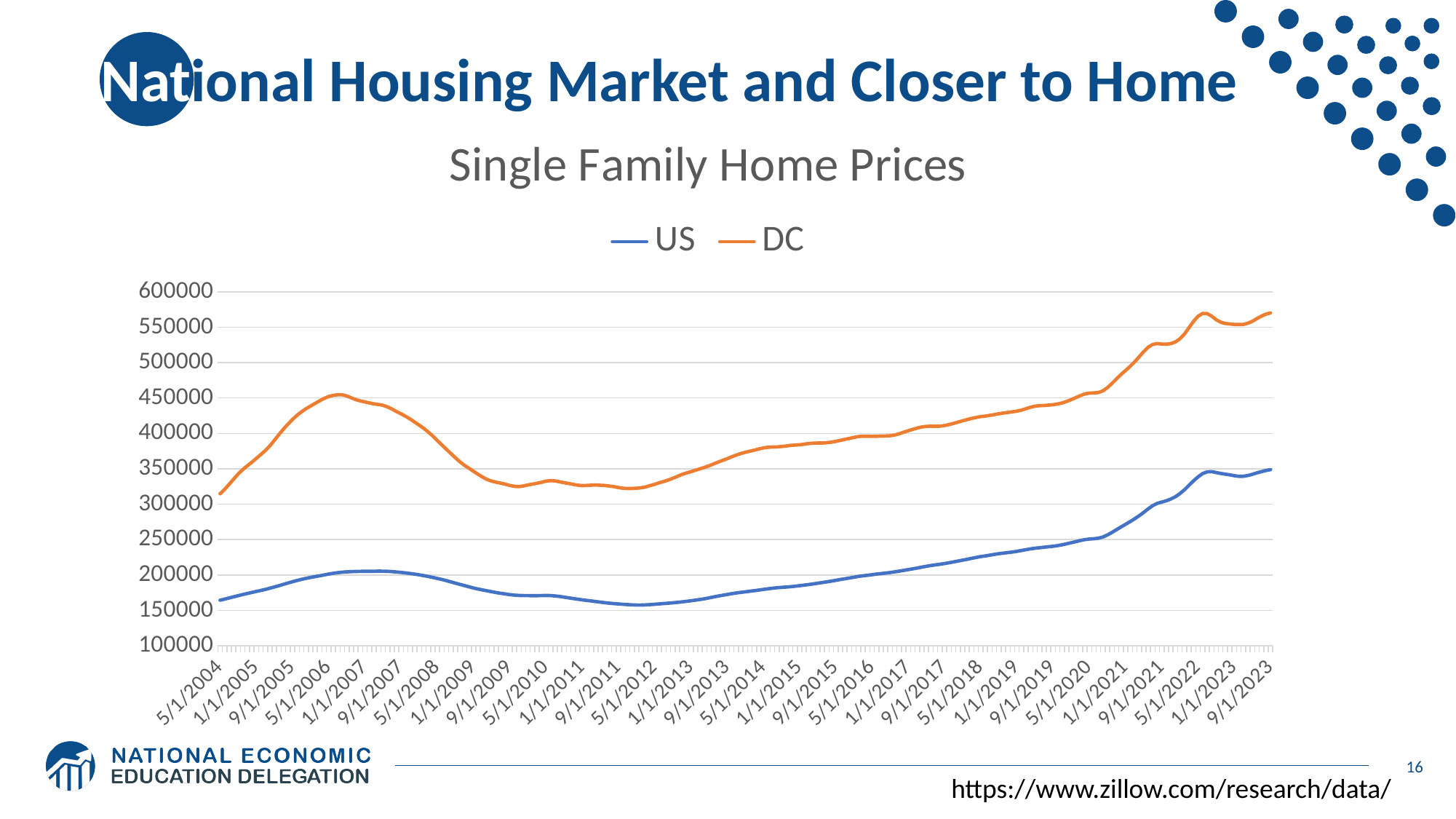
What is the title of the chart? Single Family Home Prices Is the value for US at 5/1/2004 greater or less than 150000? greater Is the value for US at 5/1/2012 greater or less than 200000? less Is the value for DC at 1/1/2007 greater or less than 400000? greater Which colour is used for the DC series? orange Does the DC series rise or fall between 1/1/2007 and 5/1/2009? fall Does the US series rise or fall between 5/1/2012 and 9/1/2023? rise Which series has the higher value at 9/1/2023, US or DC? DC Which series is higher at 1/1/2017, US or DC? DC How many series does the legend list? 2 What kind of chart is shown on the slide? line chart